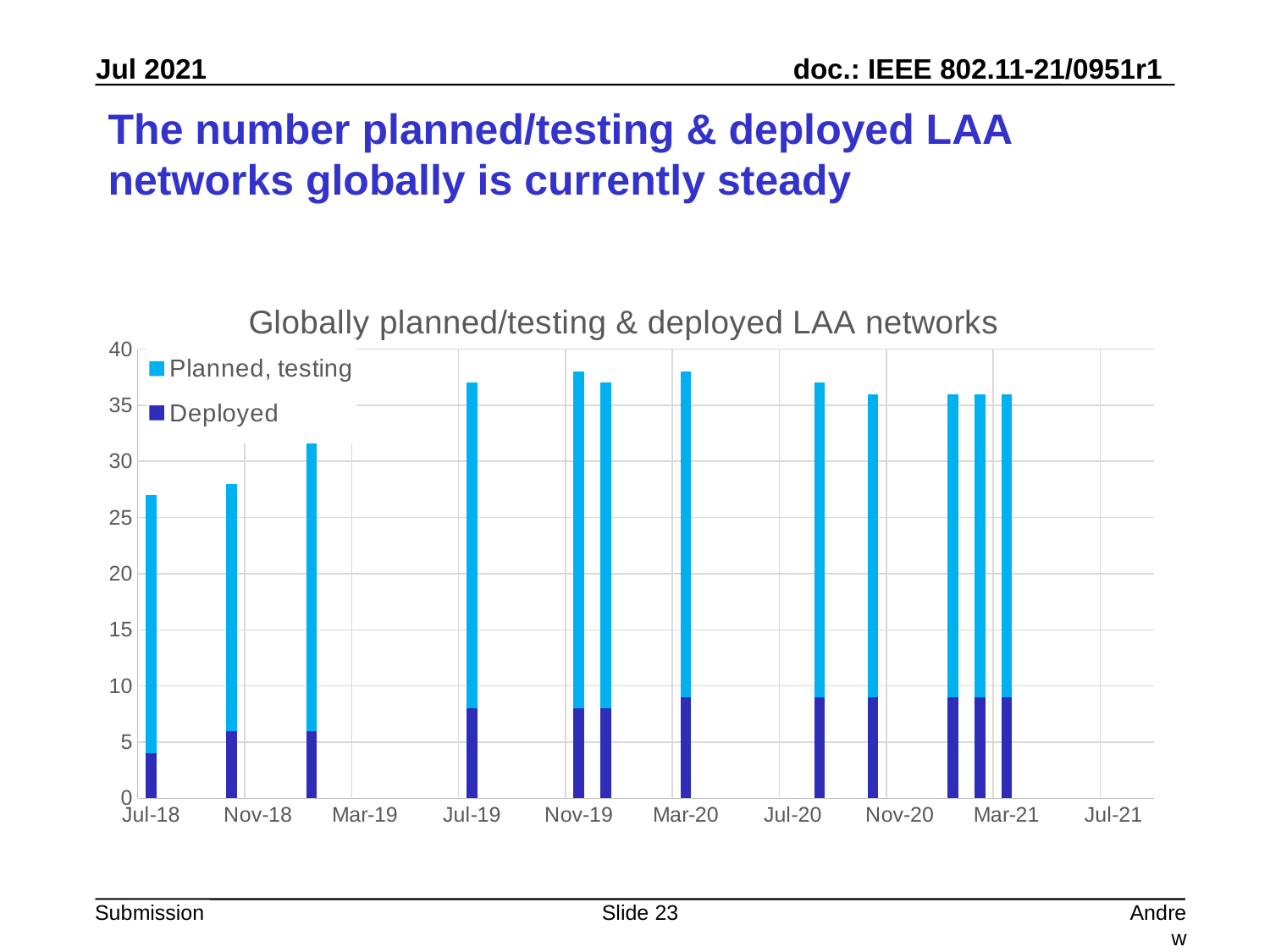
Does the total number of networks rise or fall from Jul-18 to Jul-19? Rise Which bar is taller in total, Jul-18 or Jul-19? Jul-19 Is the Deployed value at Mar-20 greater or less than 5? greater What kind of chart is shown on the slide? Stacked bar chart Is the Deployed value at Jul-18 greater or less than 5? less How many series does the chart legend list? 2 Is the total height of the bar at Jul-18 greater or less than 25? greater What are the two series named in the legend? Planned, testing; Deployed What is the title of the chart? Globally planned/testing & deployed LAA networks